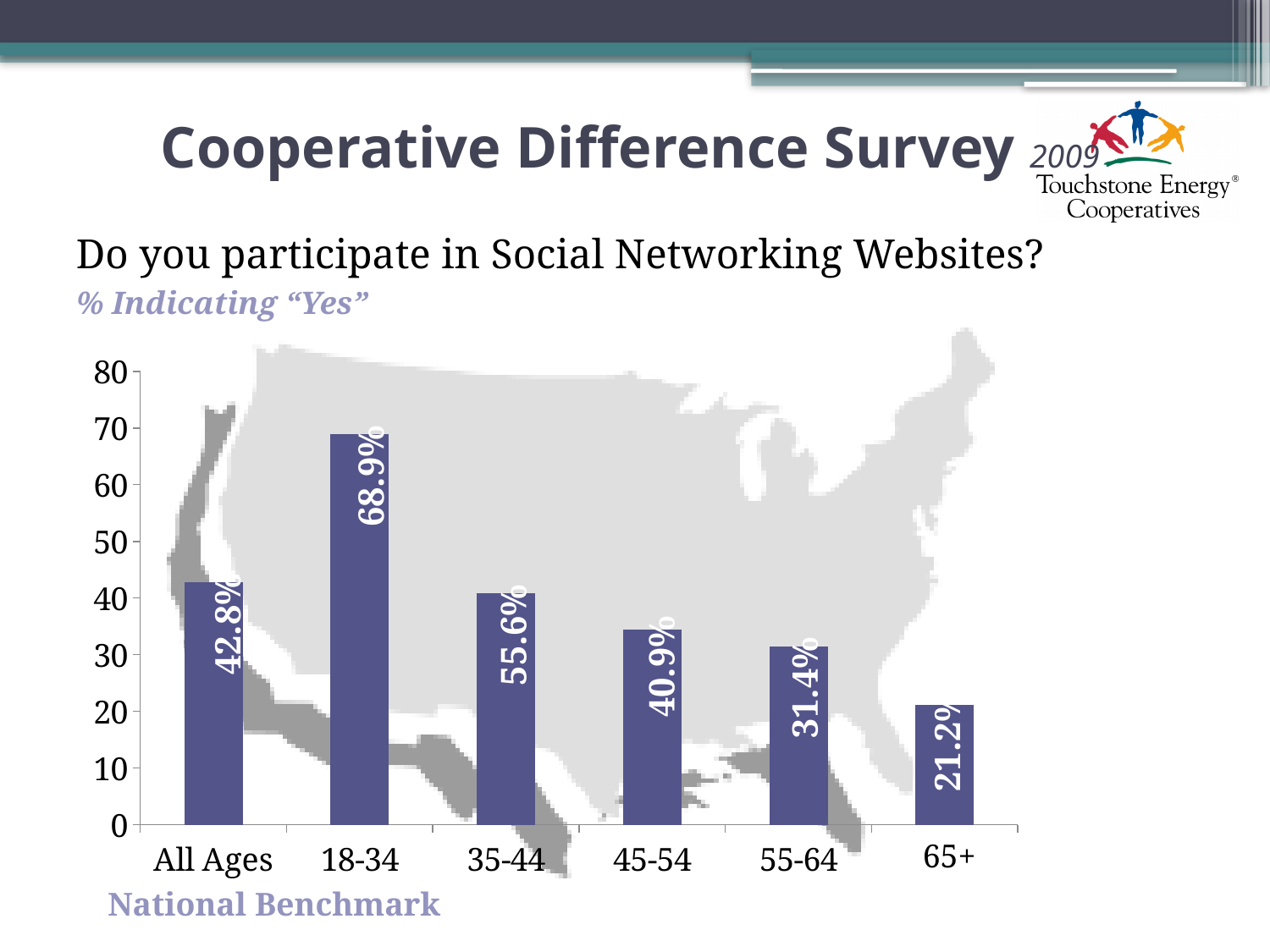
What is the value shown for the 65+ age group? 21.2% Which age group has the lowest percentage indicating "Yes"? 65+ What is the value shown for All Ages? 42.8% Which is larger, the value for 35-44 or the value for 45-54? 35-44 Which age group has the highest percentage indicating "Yes"? 18-34 How many categories are shown on the x axis? 6 What is the difference between the values for the 18-34 group and the 65+ group? 47.7 percentage points Is the value for the 18-34 group greater or less than 60? greater What percentage of the 18-34 age group indicated "Yes" to participating in social networking websites? 68.9% What is the value shown for the 55-64 age group? 31.4% What is the difference between the values for All Ages and the 55-64 group? 11.4 percentage points What kind of chart is shown on the slide? Bar chart